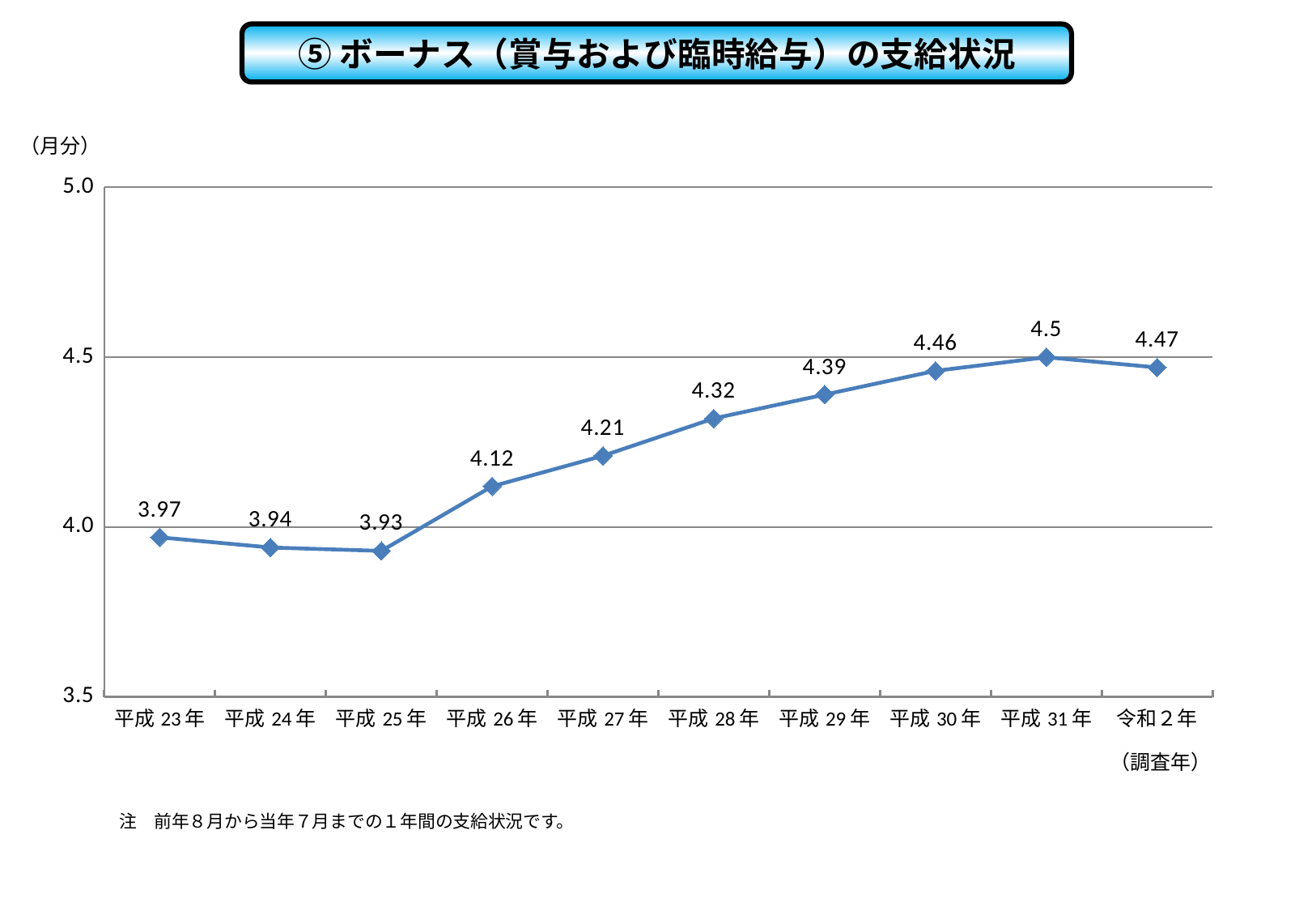
What is the value for 平成 26 年? 4.12 What is the value for 平成 23 年? 3.97 Which year has the lowest value? 平成 25 年 What unit is shown on the vertical axis? 月分 What kind of chart is shown? line chart What is the value for 令和 2 年? 4.47 Which year has the highest value? 平成 31 年 What is the difference between the values for 平成 31 年 and 平成 23 年? 0.53 How many years are plotted on the chart? 10 What is the difference between the values for 平成 28 年 and 平成 27 年? 0.11 Which is larger, the value for 平成 29 年 or the value for 平成 26 年? 平成 29 年 Is the value for 平成 30 年 greater or less than 4.0? greater